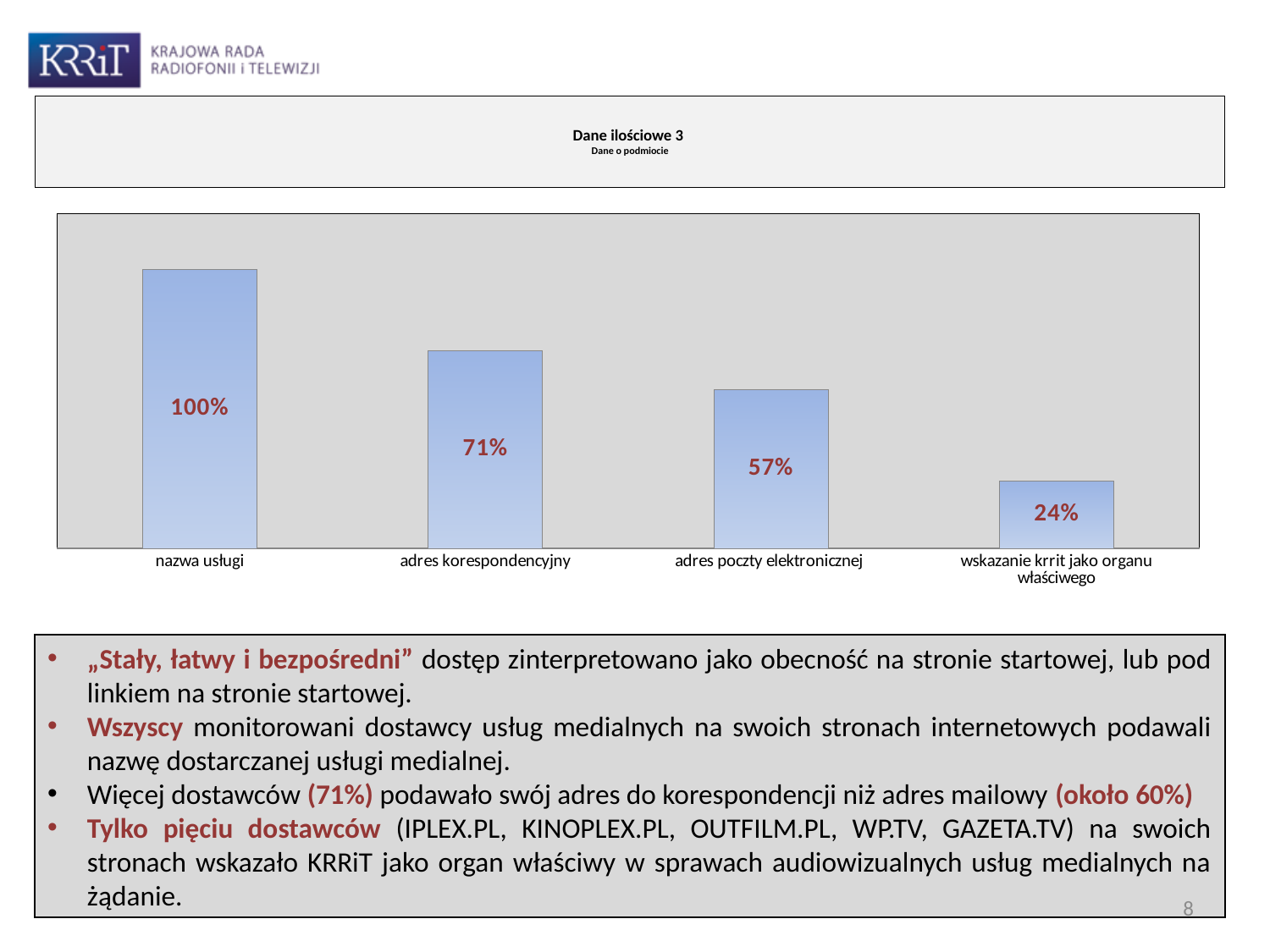
What kind of chart is shown on the slide? bar chart What is the value for "adres korespondencyjny"? 71% What is the value for "wskazanie krrit jako organu właściwego"? 24% What is the value for "nazwa usługi"? 100% Which category has the highest value? nazwa usługi Which is larger: the value for "adres korespondencyjny" or the value for "adres poczty elektronicznej"? adres korespondencyjny How many categories are shown in the chart? 4 Do the values rise or fall from left to right across the categories? fall What is the difference between the values for "nazwa usługi" and "wskazanie krrit jako organu właściwego"? 76% What is the difference between the values for "adres korespondencyjny" and "adres poczty elektronicznej"? 14% What is the value for "adres poczty elektronicznej"? 57% Which category has the lowest value? wskazanie krrit jako organu właściwego